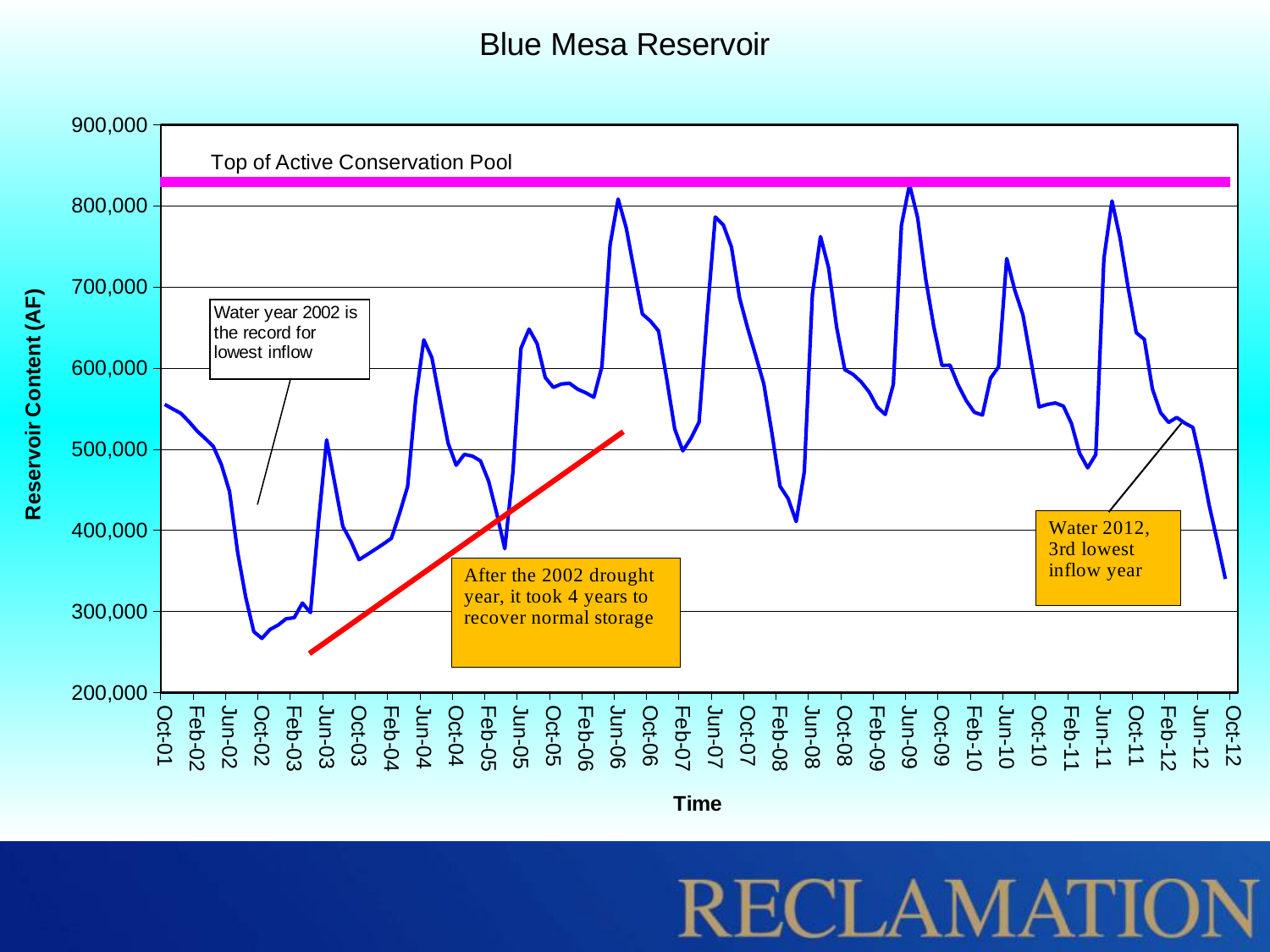
What kind of chart is shown on the slide? line chart Is the reservoir content at Jun-06 greater or less than 800,000? greater Is the reservoir content at Feb-11 greater or less than 500,000? greater Is the reservoir content at Oct-12 greater or less than 400,000? less What is the title of the chart? Blue Mesa Reservoir What is the label of the vertical axis? Reservoir Content (AF) Which is larger, the reservoir content at Jun-09 or at Oct-02? Jun-09 Does the reservoir content rise or fall between Feb-06 and Jun-06? rise Does the reservoir content rise or fall between Oct-01 and Oct-02? fall